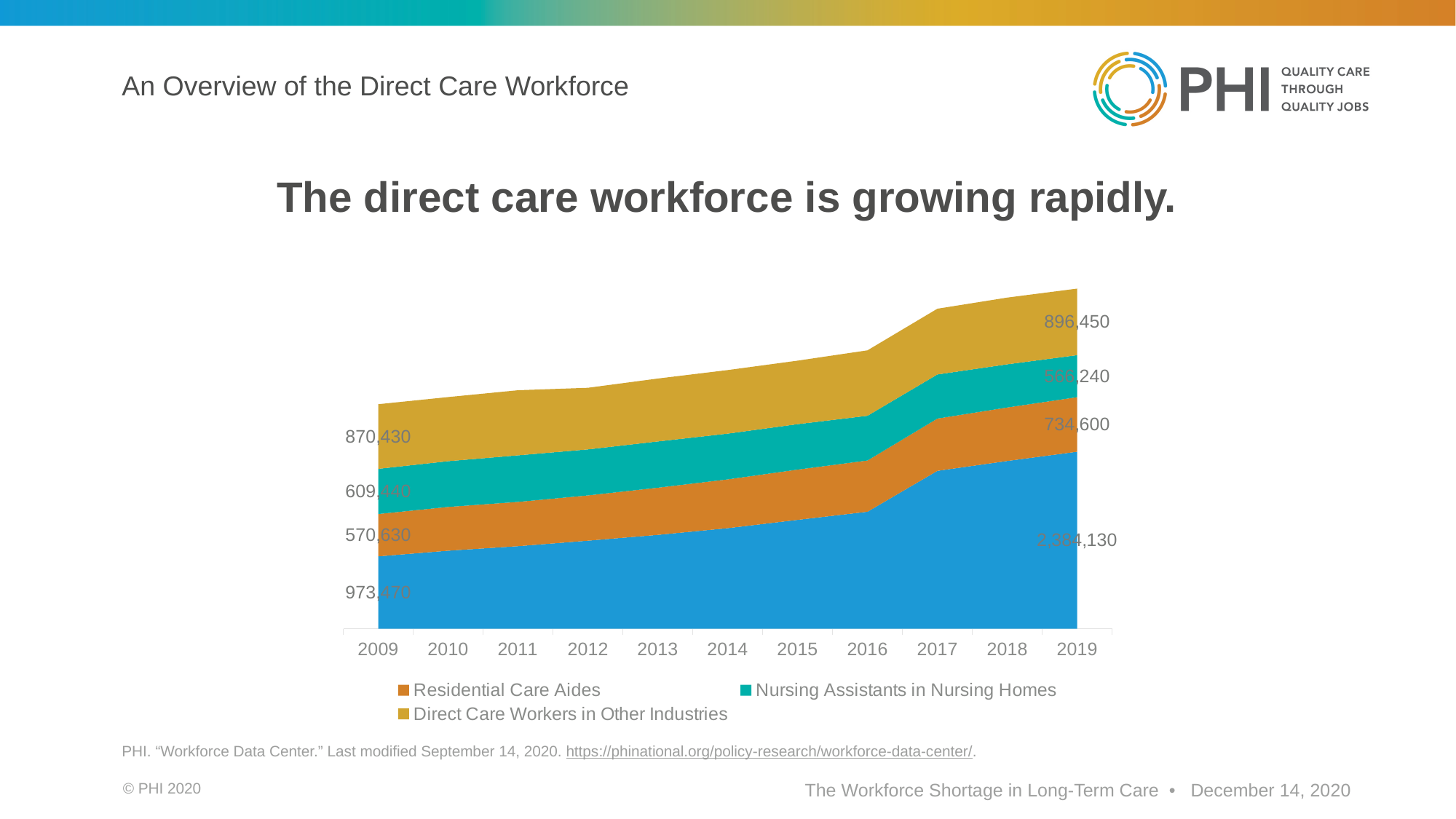
What is the value for Residential Care Aides in 2019? 734,600 What kind of chart is shown on the slide? Stacked area chart What is the value for Direct Care Workers in Other Industries in 2019? 896,450 What is the value for Direct Care Workers in Other Industries in 2009? 870,430 By how much did the value for Nursing Assistants in Nursing Homes decrease from 2009 to 2019? 43,200 By how much did the value for Residential Care Aides increase from 2009 to 2019? 163,970 What is the value for Nursing Assistants in Nursing Homes in 2019? 566,240 How many years are shown on the x axis? 11 In 2019, which is larger: Residential Care Aides or Nursing Assistants in Nursing Homes? Residential Care Aides What is the value for Residential Care Aides in 2009? 570,630 Did the value for Nursing Assistants in Nursing Homes rise or fall between 2009 and 2019? Fall How many series does the legend list? 3